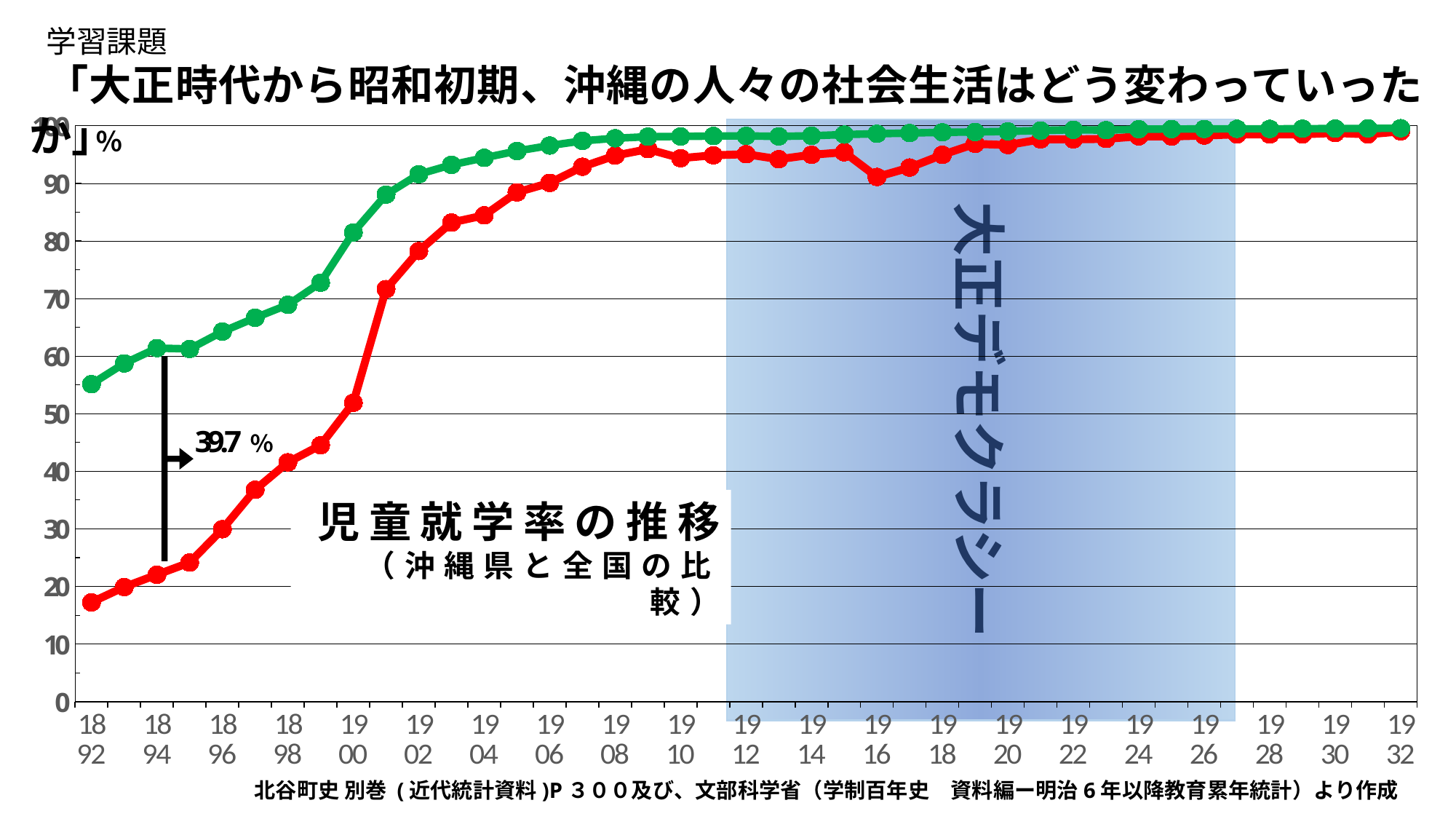
Is the value of the red line in 1904 greater or less than 80? greater What is the last year shown on the x axis? 1932 How many year labels are shown along the x axis? 21 What is the first year shown on the x axis? 1892 What is the title of the chart? 児童就学率の推移（沖縄県と全国の比較） What gap between the two lines is labelled on the chart for 1894? 39.7% What label is written in the shaded blue region of the chart? 大正デモクラシー Is the value of the red line in 1892 greater or less than 20? less What kind of chart is shown on the slide? line chart In 1894, which line has the higher value, the green line or the red line? the green line Do the values of the red line rise or fall from 1892 to 1908? rise Is the value of the green line in 1892 greater or less than 50? greater